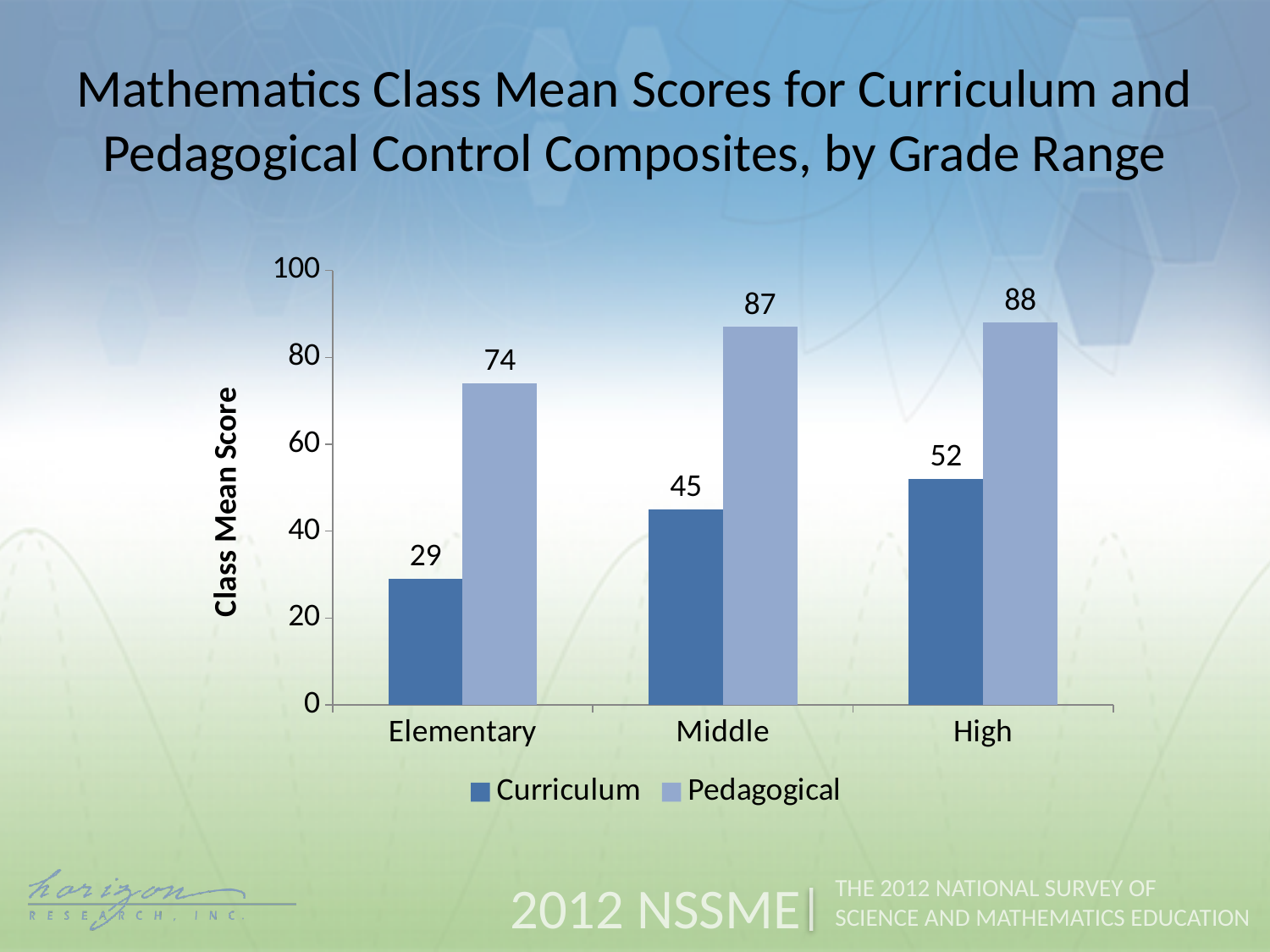
Is the Curriculum score for High greater or less than 40? greater Which grade range has the lowest Curriculum score? Elementary What is the Pedagogical class mean score for Middle? 87 What is the difference between the Pedagogical and Curriculum scores for Elementary? 45 What is the Curriculum class mean score for High? 52 What kind of chart is shown on the slide? Bar chart Which is larger for Middle, the Curriculum score or the Pedagogical score? Pedagogical What is the Curriculum class mean score for Elementary? 29 Which grade range has the highest Pedagogical score? High Do the Curriculum scores rise or fall from Elementary to High? Rise How many series does the legend list? 2 How many grade ranges are shown on the x axis? 3